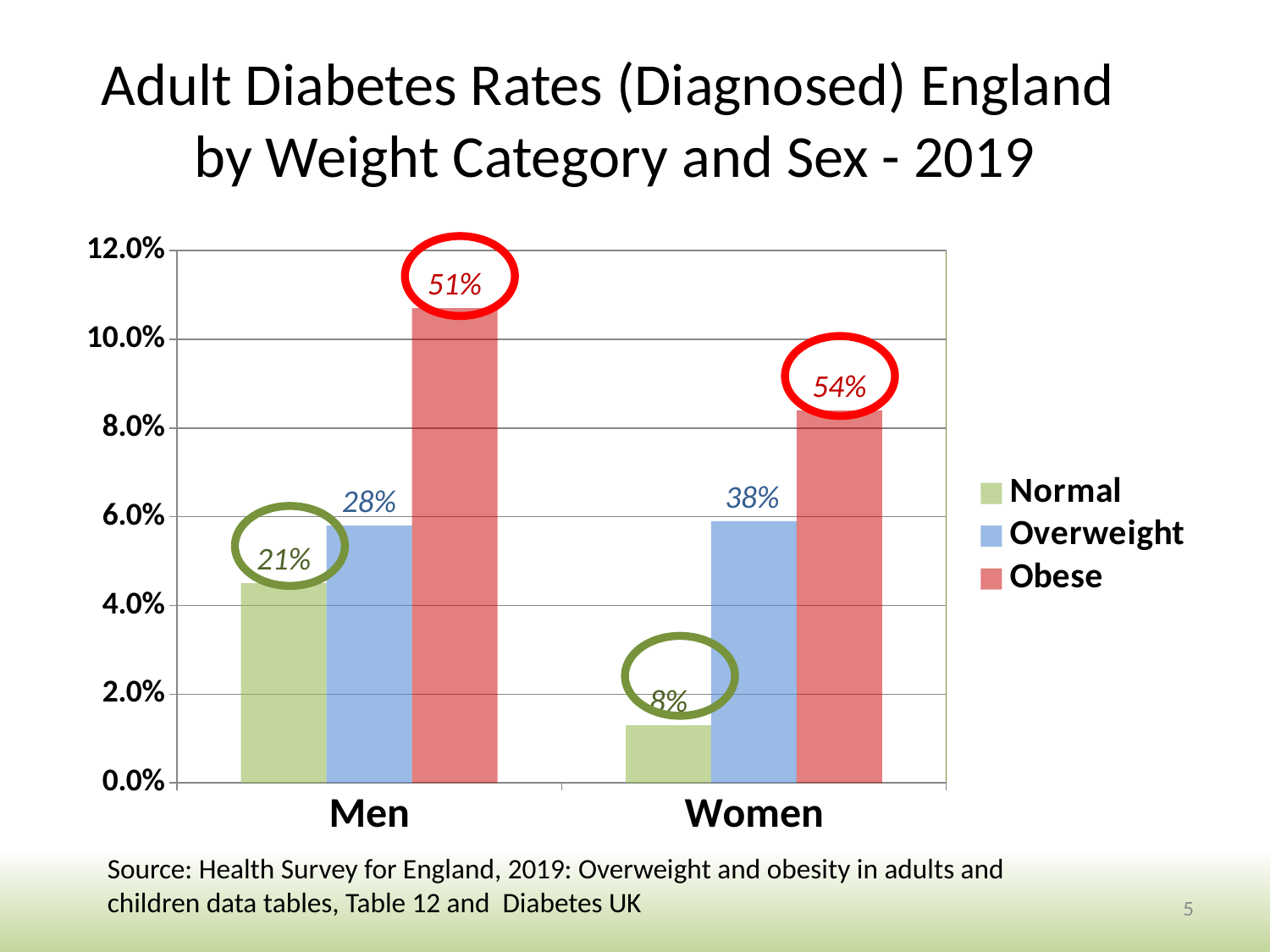
Is the Obese diabetes rate for Women greater or less than 8.0%? greater Is the Normal diabetes rate for Women greater or less than 2.0%? less Which weight category has the lowest diabetes rate for Women? Normal Is the Normal diabetes rate for Men greater or less than 6.0%? less Which is larger, the Obese diabetes rate for Men or for Women? Men How many categories are shown on the x axis? 2 What kind of chart is shown on the slide? bar chart Which weight category has the highest diabetes rate for Men? Obese Which bar is the tallest in the whole chart? Obese for Men How many series does the legend list? 3 What colour represents the Obese series in the legend? red